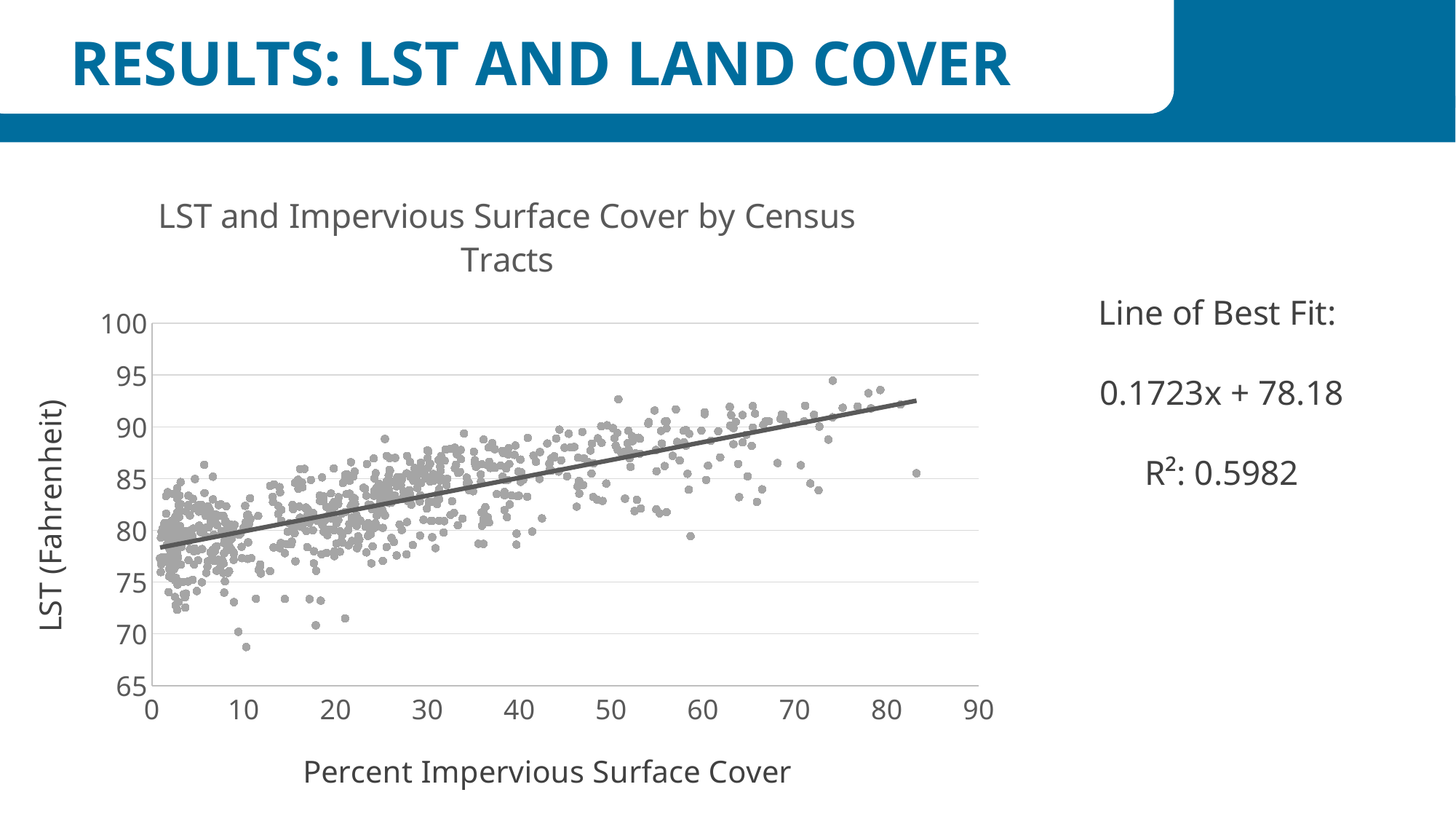
What is the R² value reported for the line of best fit? 0.5982 As Percent Impervious Surface Cover increases along the x axis, does LST generally rise or fall? Rise What is the label of the y axis of the chart? LST (Fahrenheit) Is the lowest plotted LST value on the chart greater or less than 70? less What is the equation of the line of best fit shown next to the chart? 0.1723x + 78.18 What is the title of the chart? LST and Impervious Surface Cover by Census Tracts Is the highest plotted LST value on the chart greater or less than 90? greater What is the intercept of the line of best fit? 78.18 What kind of chart is shown on the slide? Scatter chart Is the line of best fit at 80 percent impervious surface cover greater or less than 90 degrees Fahrenheit? greater What is the slope of the line of best fit? 0.1723 What is the highest value shown on the x axis of the chart? 90